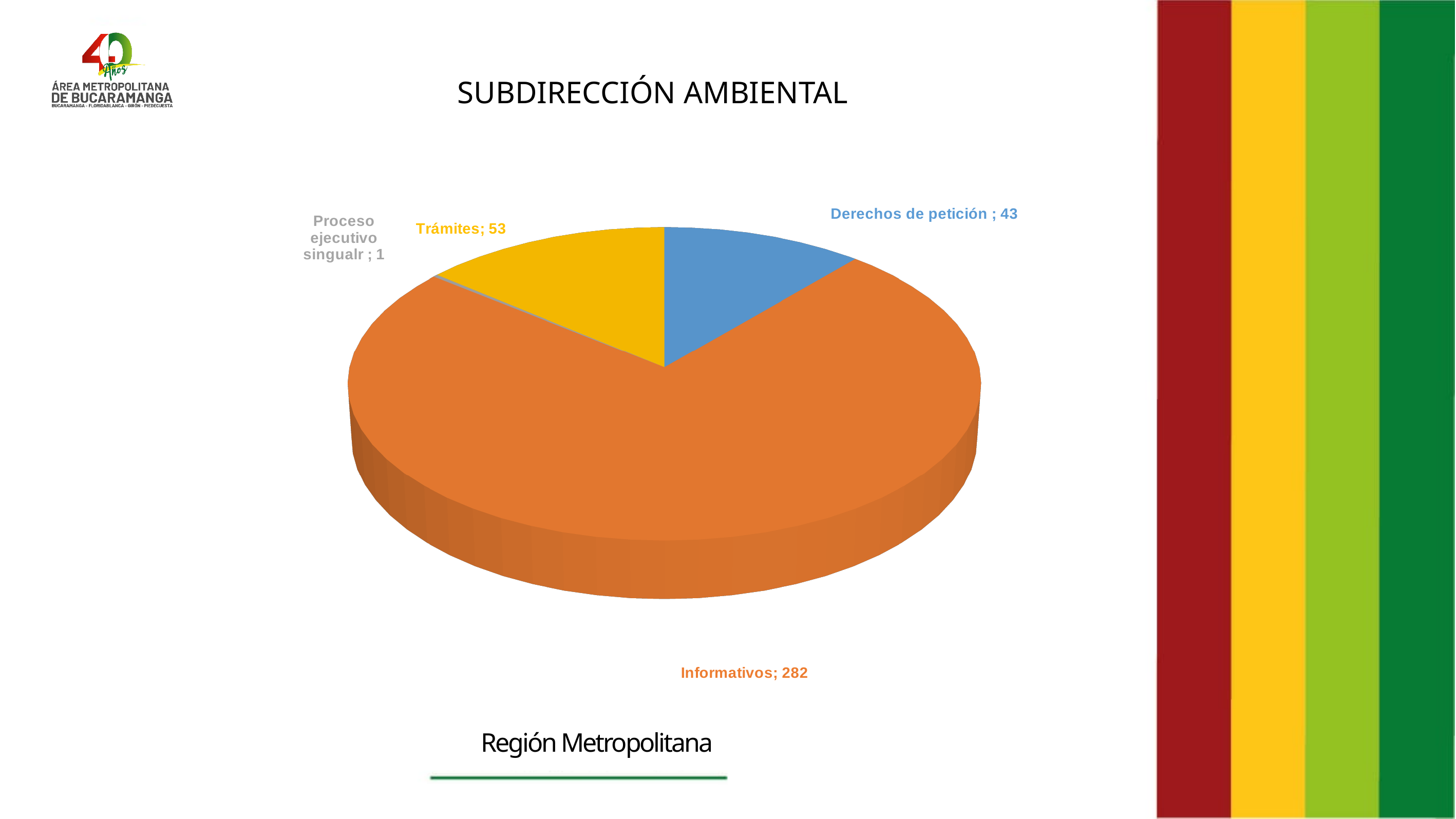
What is the value for Derechos de petición? 43 Which category has the smallest slice of the pie? Proceso ejecutivo singualr What is the value for Trámites? 53 How many categories are shown in the pie chart? 4 What is the difference between the values for Trámites and Derechos de petición? 10 What is the difference between the values for Informativos and Trámites? 229 Which category has the largest slice of the pie? Informativos What is the value for Proceso ejecutivo singualr? 1 Which is larger, Trámites or Derechos de petición? Trámites What is the value for Informativos? 282 What kind of chart is shown on the slide? Pie chart What colour is the Informativos slice? Orange